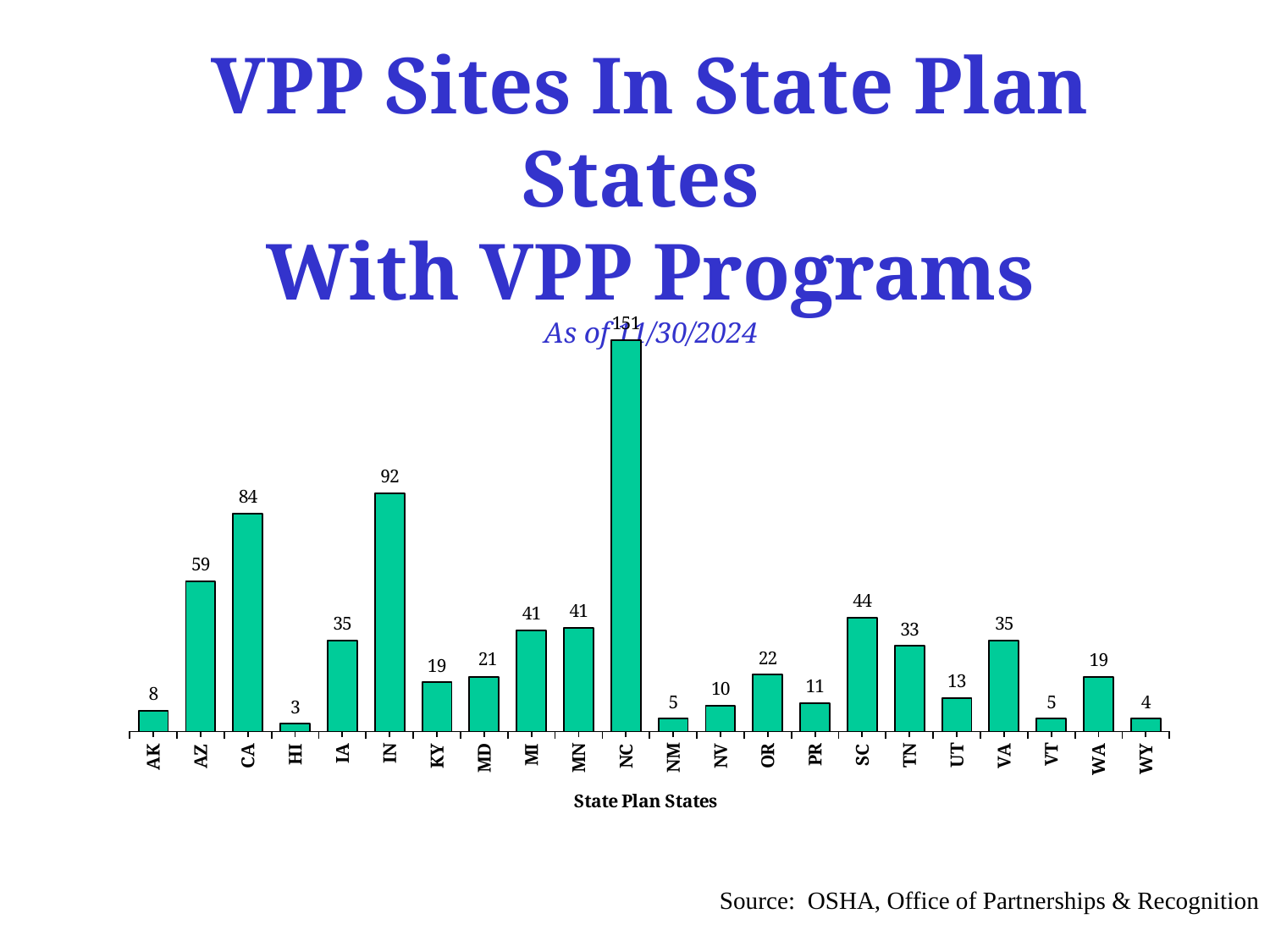
What is the value shown for IN? 92 Which state has the lowest number of VPP sites? HI What is the value shown for SC? 44 Which state has the highest number of VPP sites? NC What is the difference between the values for AZ and TN? 26 What is the x-axis title of the chart? State Plan States Which has more VPP sites, VA or WA? VA How many states are shown on the x axis of the chart? 22 How many VPP sites does California (CA) have? 84 What is the difference between the values for IN and CA? 8 What kind of chart is shown on the slide? bar chart Which has more VPP sites, OR or UT? OR